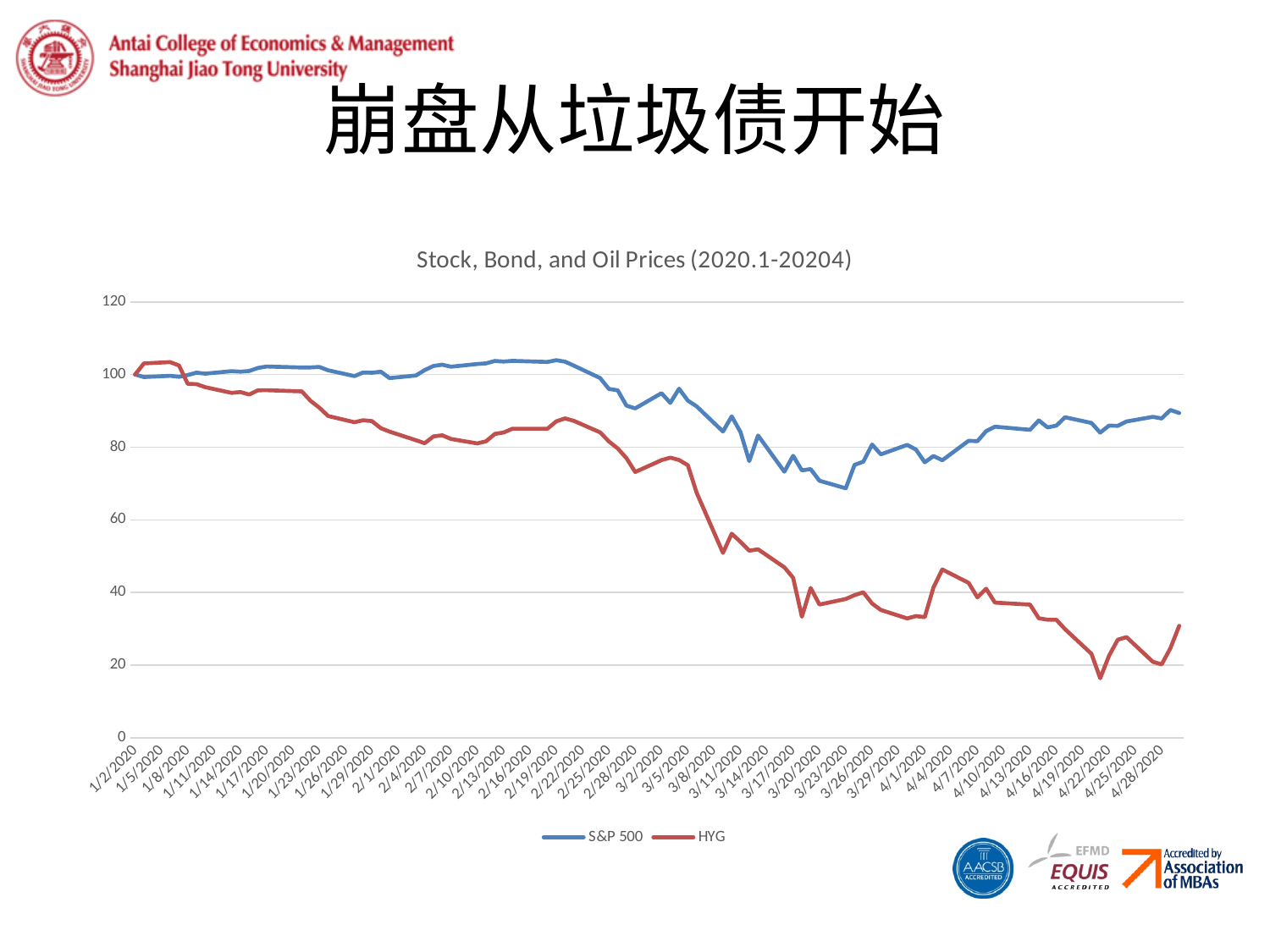
Does the S&P 500 line rise or fall between 3/23/2020 and 4/28/2020? rise Does the HYG line rise or fall between 2/22/2020 and 3/20/2020? fall What are the two series named in the legend? S&P 500 and HYG Is the value of HYG on 3/20/2020 greater or less than 40? less On 3/23/2020, which series has the higher value, S&P 500 or HYG? S&P 500 Is the value of the S&P 500 on 3/23/2020 greater or less than 80? less Is the value of the S&P 500 on 2/19/2020 greater or less than 100? greater How many series does the legend list? 2 What is the title of the chart? Stock, Bond, and Oil Prices (2020.1-20204) What kind of chart is shown on the slide? line chart